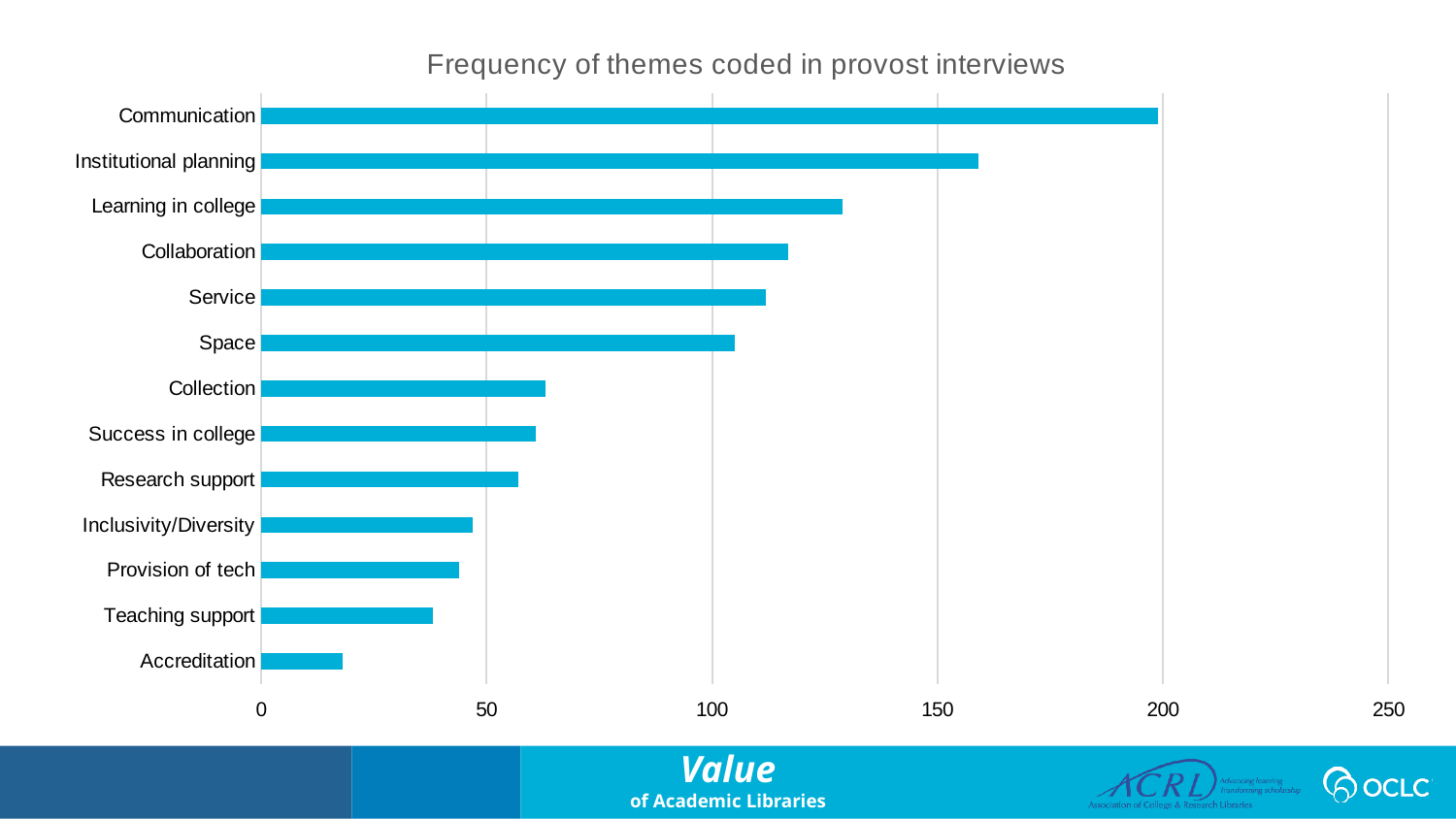
Is the value for Accreditation greater or less than 50? less Is the value for Institutional planning greater or less than 150? greater What is the title of the chart? Frequency of themes coded in provost interviews Is the value for Space greater or less than 100? greater What kind of chart is shown on the slide? bar chart Which theme has the lowest frequency? Accreditation How many themes (categories) are plotted in the chart? 13 Which has a higher frequency, Learning in college or Service? Learning in college Which has a higher frequency, Teaching support or Research support? Research support Which theme has the highest frequency? Communication